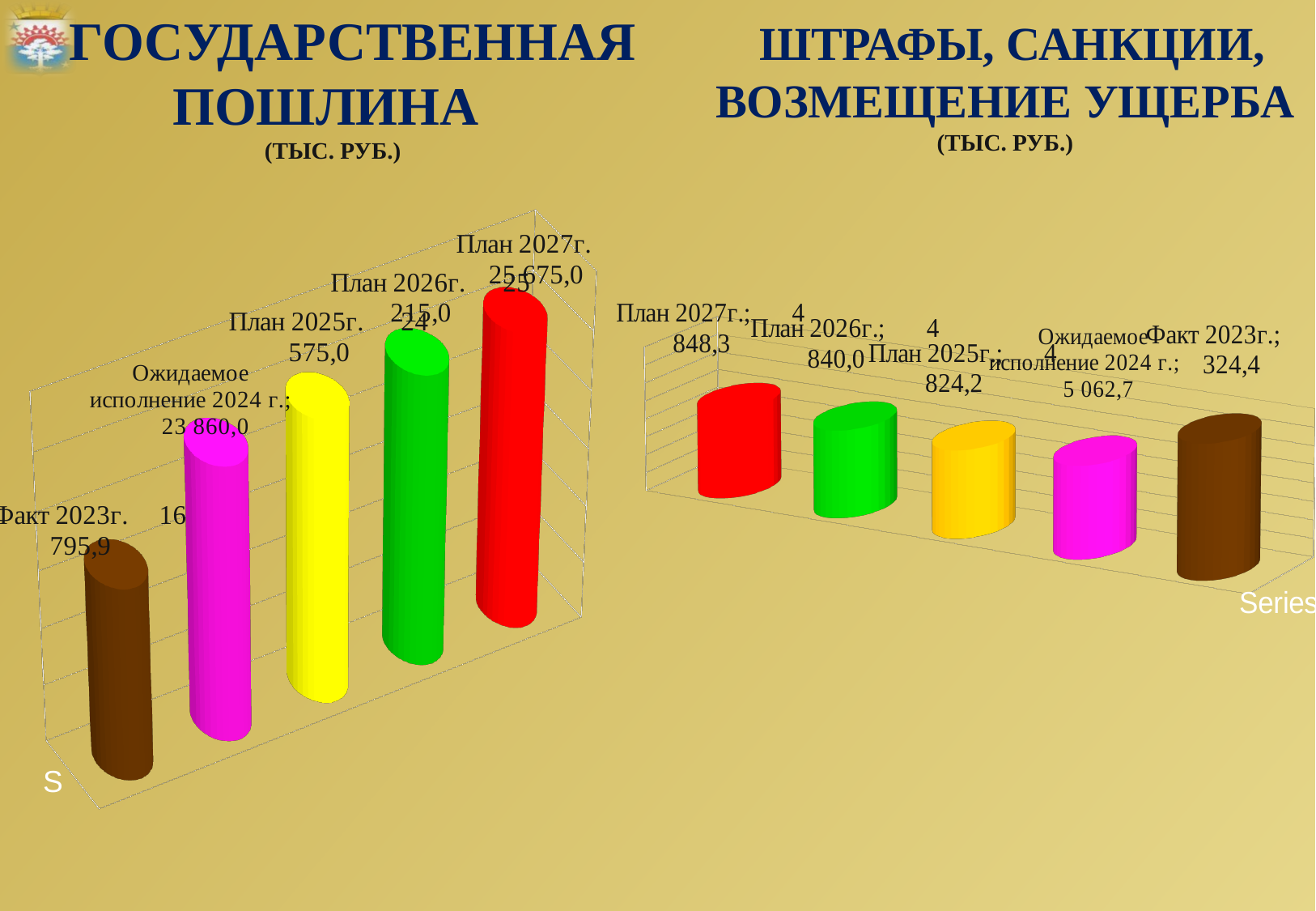
On the left chart (ГОСУДАРСТВЕННАЯ ПОШЛИНА), what is the value for Ожидаемое исполнение 2024 г.? 23 860,0 On the left chart (ГОСУДАРСТВЕННАЯ ПОШЛИНА), which category has the lowest value? Факт 2023г. On the right chart (ШТРАФЫ, САНКЦИИ, ВОЗМЕЩЕНИЕ УЩЕРБА), which category has the tallest bar? Факт 2023г. What kind of chart is the right chart (ШТРАФЫ, САНКЦИИ, ВОЗМЕЩЕНИЕ УЩЕРБА)? bar chart On the left chart (ГОСУДАРСТВЕННАЯ ПОШЛИНА), what is the value for План 2027г.? 25 675,0 On the right chart (ШТРАФЫ, САНКЦИИ, ВОЗМЕЩЕНИЕ УЩЕРБА), what is the value for План 2026г.? 4 840,0 On the right chart (ШТРАФЫ, САНКЦИИ, ВОЗМЕЩЕНИЕ УЩЕРБА), what is the value for Ожидаемое исполнение 2024 г.? 5 062,7 On the right chart (ШТРАФЫ, САНКЦИИ, ВОЗМЕЩЕНИЕ УЩЕРБА), what is the difference between План 2027г. and План 2026г.? 8,3 On the left chart (ГОСУДАРСТВЕННАЯ ПОШЛИНА), which category has the highest value? План 2027г. On the left chart (ГОСУДАРСТВЕННАЯ ПОШЛИНА), do the values rise or fall from Факт 2023г. to План 2027г.? rise On the right chart (ШТРАФЫ, САНКЦИИ, ВОЗМЕЩЕНИЕ УЩЕРБА), which is larger: Ожидаемое исполнение 2024 г. or План 2025г.? Ожидаемое исполнение 2024 г. On the left chart (ГОСУДАРСТВЕННАЯ ПОШЛИНА), how many bars are shown? 5